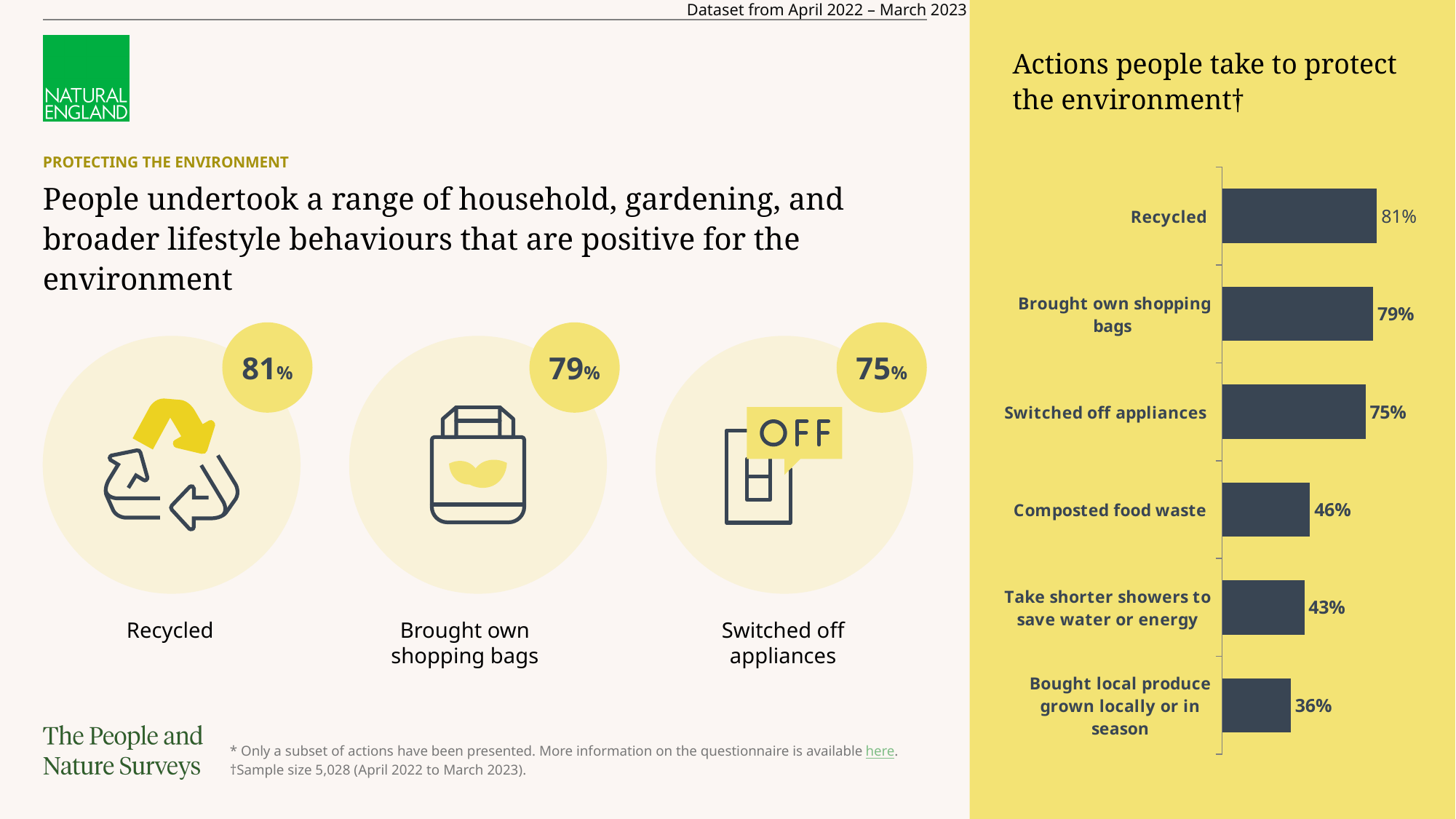
Which action has the highest percentage in the bar chart? Recycled How many actions are shown in the bar chart? 6 What type of chart is used to show the actions people take to protect the environment? Bar chart Which action has the lowest percentage in the bar chart? Bought local produce grown locally or in season What is the value for 'Bought local produce grown locally or in season'? 36% What is the difference between the percentage for 'Recycled' and 'Switched off appliances'? 6% What is the value for 'Composted food waste' in the bar chart? 46% What is the difference between 'Composted food waste' and 'Bought local produce grown locally or in season'? 10% Which is larger: the value for 'Switched off appliances' or 'Composted food waste'? Switched off appliances What is the value for 'Take shorter showers to save water or energy'? 43% What percentage of people recycled, according to the bar chart? 81% What is the title of the bar chart? Actions people take to protect the environment†